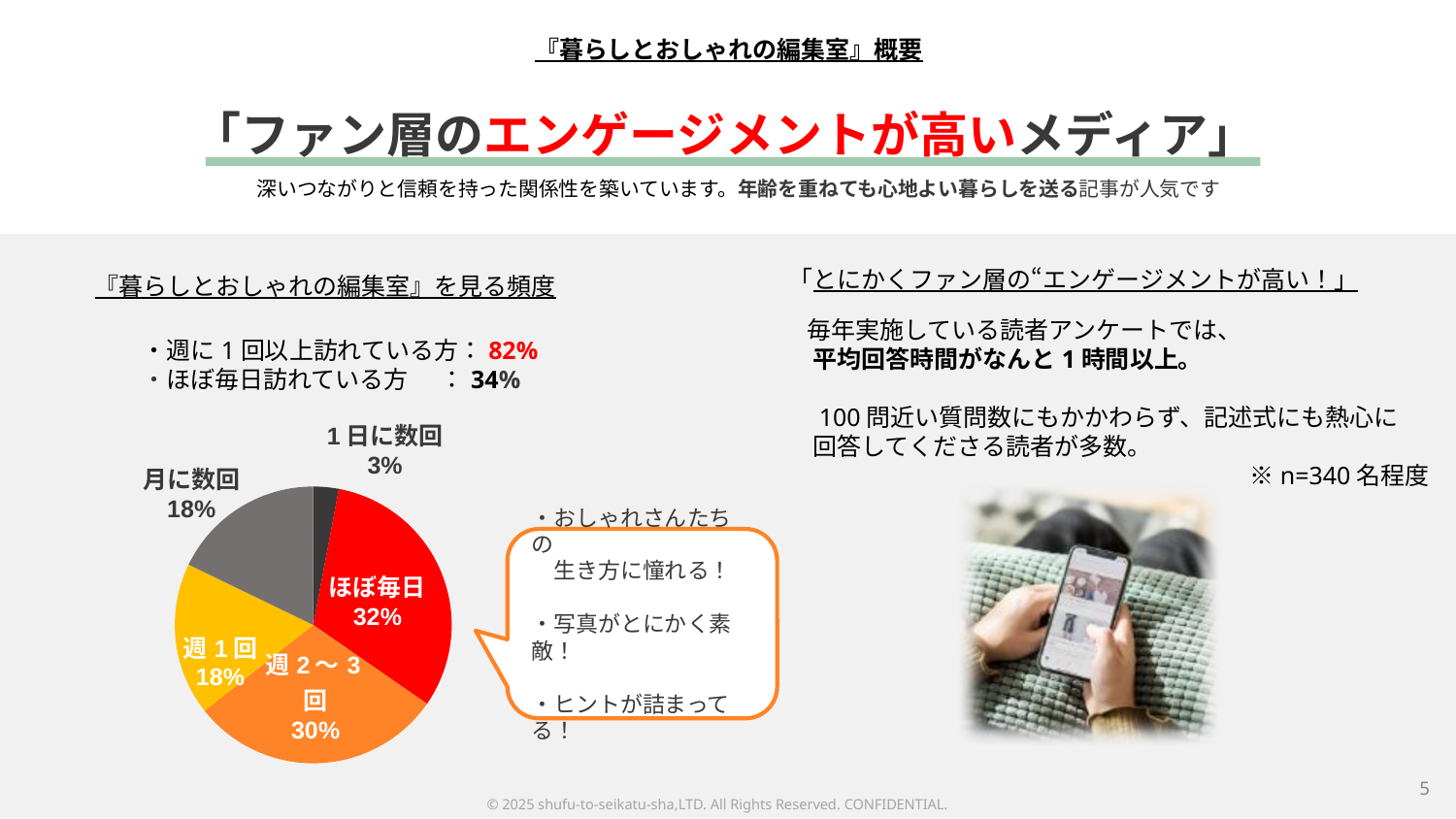
What is the combined share of the ほぼ毎日 and 1日に数回 slices? 35% What share of the pie chart is labelled 1日に数回? 3% How many slices does the pie chart have? 5 What share of the pie chart is labelled 月に数回? 18% What is the difference in percentage points between the ほぼ毎日 slice and the 週2〜3回 slice? 2 Which slice of the pie chart is the largest? ほぼ毎日 What share of the pie chart is labelled 週2〜3回? 30% Which is larger in the pie chart, the 週1回 slice or the 1日に数回 slice? 週1回 What kind of chart is shown on the slide? pie chart Which slice of the pie chart is the smallest? 1日に数回